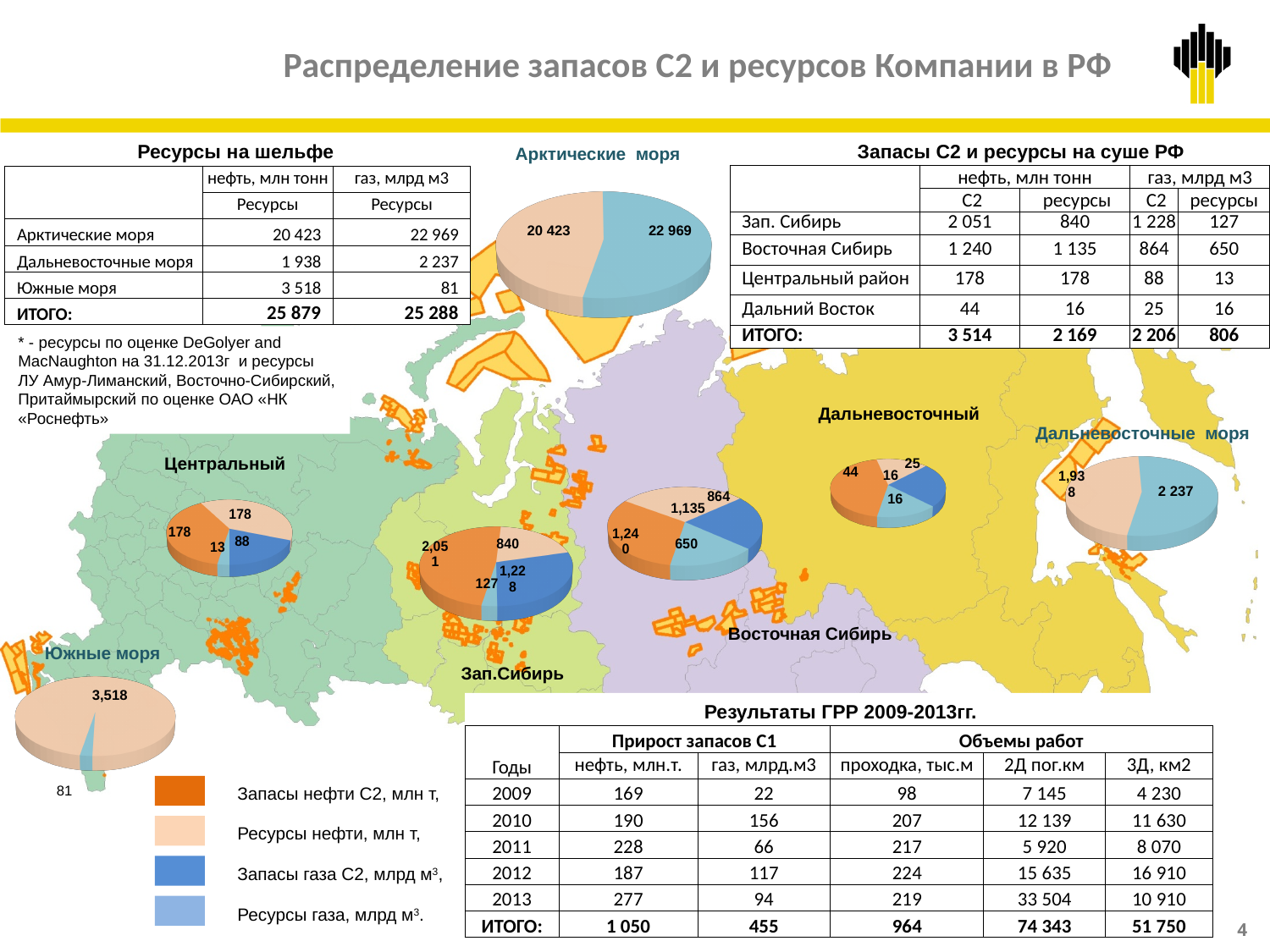
In the Южные моря pie chart, what is the value of the oil resources slice? 3,518 In the Арктические моря pie chart, what is the value of the gas resources slice (Ресурсы газа)? 22 969 In the Арктические моря pie chart, which slice is larger: oil resources or gas resources? gas resources (22 969) In the Арктические моря pie chart, what is the difference between the gas resources value and the oil resources value? 2 546 What kind of chart is used for the Арктические моря data on the map? pie chart In the Дальневосточные моря pie chart, what is the value of the gas resources slice? 2 237 In the Арктические моря pie chart, what is the value of the oil resources slice (Ресурсы нефти)? 20 423 In the Восточная Сибирь pie chart, what is the value of the gas resources slice (light blue)? 650 In the Зап.Сибирь pie chart, what is the value of the oil resources slice (Ресурсы нефти)? 840 In the Южные моря pie chart, what is the value of the gas resources slice? 81 How many categories does the legend at the bottom left of the slide list for the pie charts? 4 How many slices does the Центральный pie chart have? 4